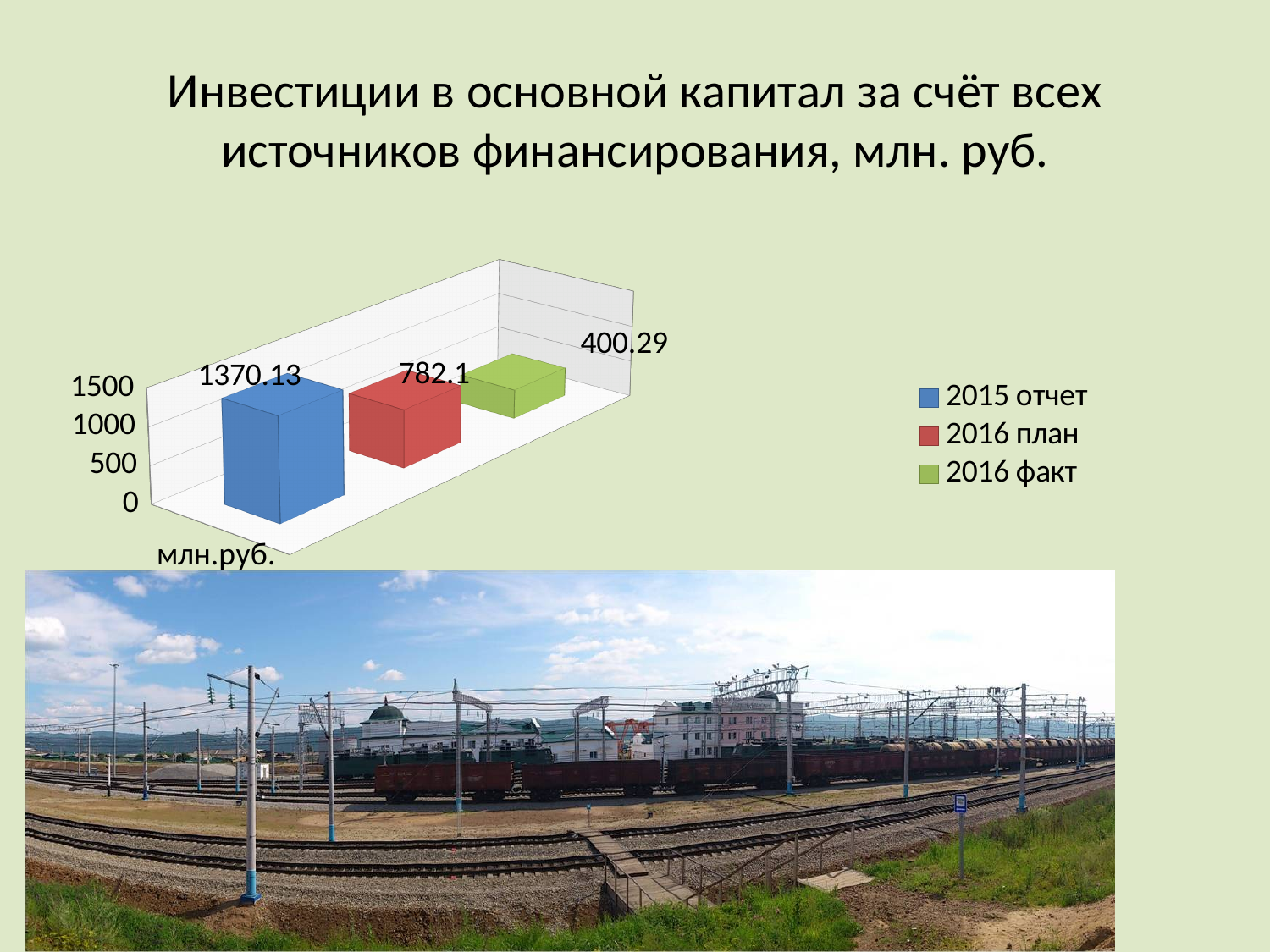
What is the value for 2015 отчет? 1370.13 What is the value for 2016 факт? 400.29 What is the value for 2016 план? 782.1 Which series has the lowest value? 2016 факт What kind of chart is shown on the slide? bar chart Which series has the highest value? 2015 отчет What is the difference between the 2016 план value and the 2016 факт value? 381.81 Is the value for 2015 отчет greater or less than 1000? greater How many series does the legend list? 3 What colour is the bar for 2016 факт? green Which is larger, the value for 2016 план or the value for 2016 факт? 2016 план What is the difference between the 2015 отчет value and the 2016 план value? 588.03